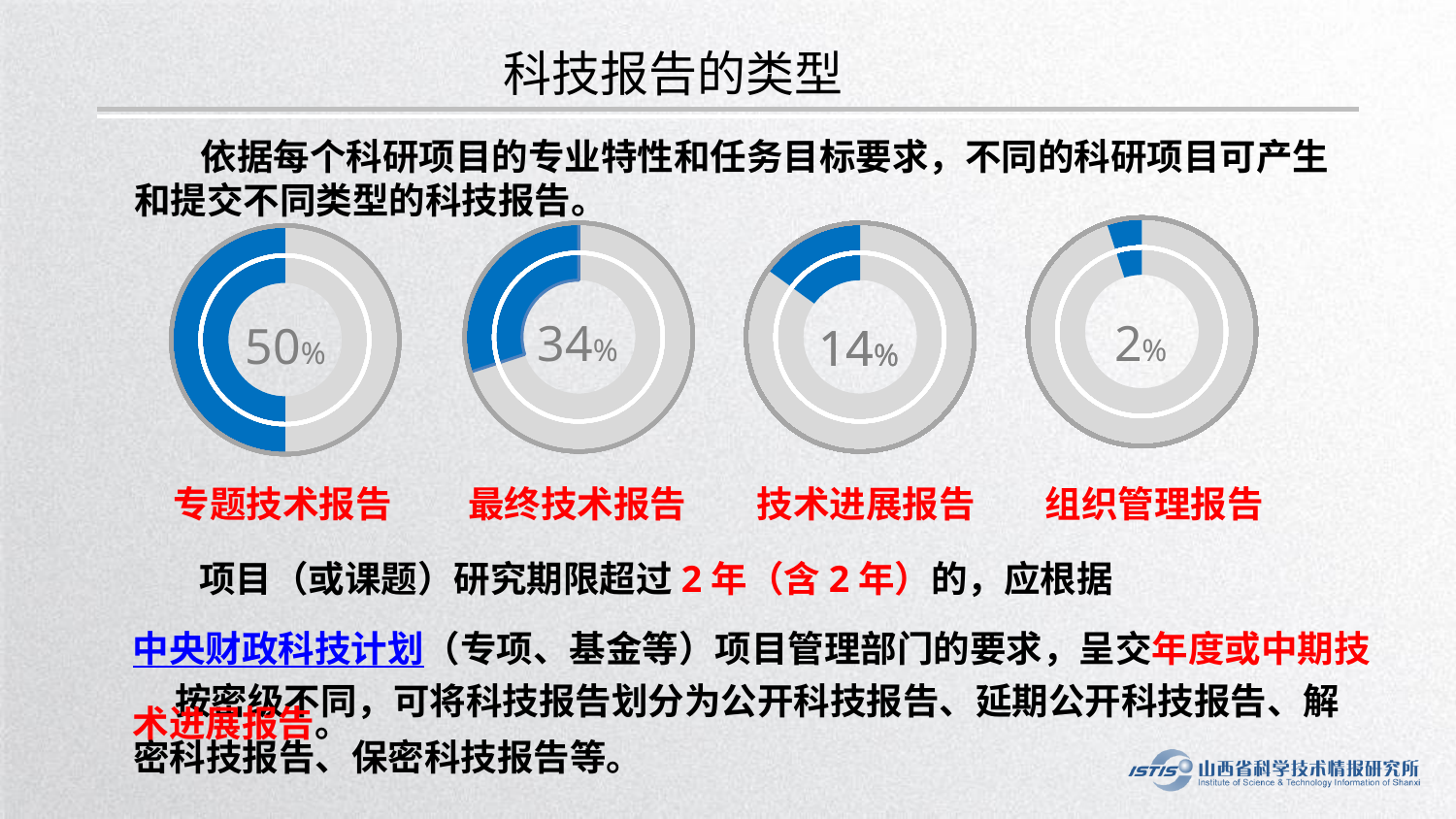
Which has a larger percentage, 最终技术报告 or 技术进展报告? 最终技术报告 What percentage is shown for 技术进展报告? 14% What percentage is shown for 组织管理报告? 2% Which report type has the highest percentage? 专题技术报告 What colour is used for the filled portion of each ring chart? Blue Which report type has the lowest percentage? 组织管理报告 What percentage is shown for 专题技术报告? 50% How many report types are shown with ring charts on the slide? 4 What is the difference in percentage between 技术进展报告 and 组织管理报告? 12% What kind of chart is used to show each report type's percentage? Donut (ring) chart What is the difference in percentage between 专题技术报告 and 最终技术报告? 16% What percentage is shown for 最终技术报告? 34%